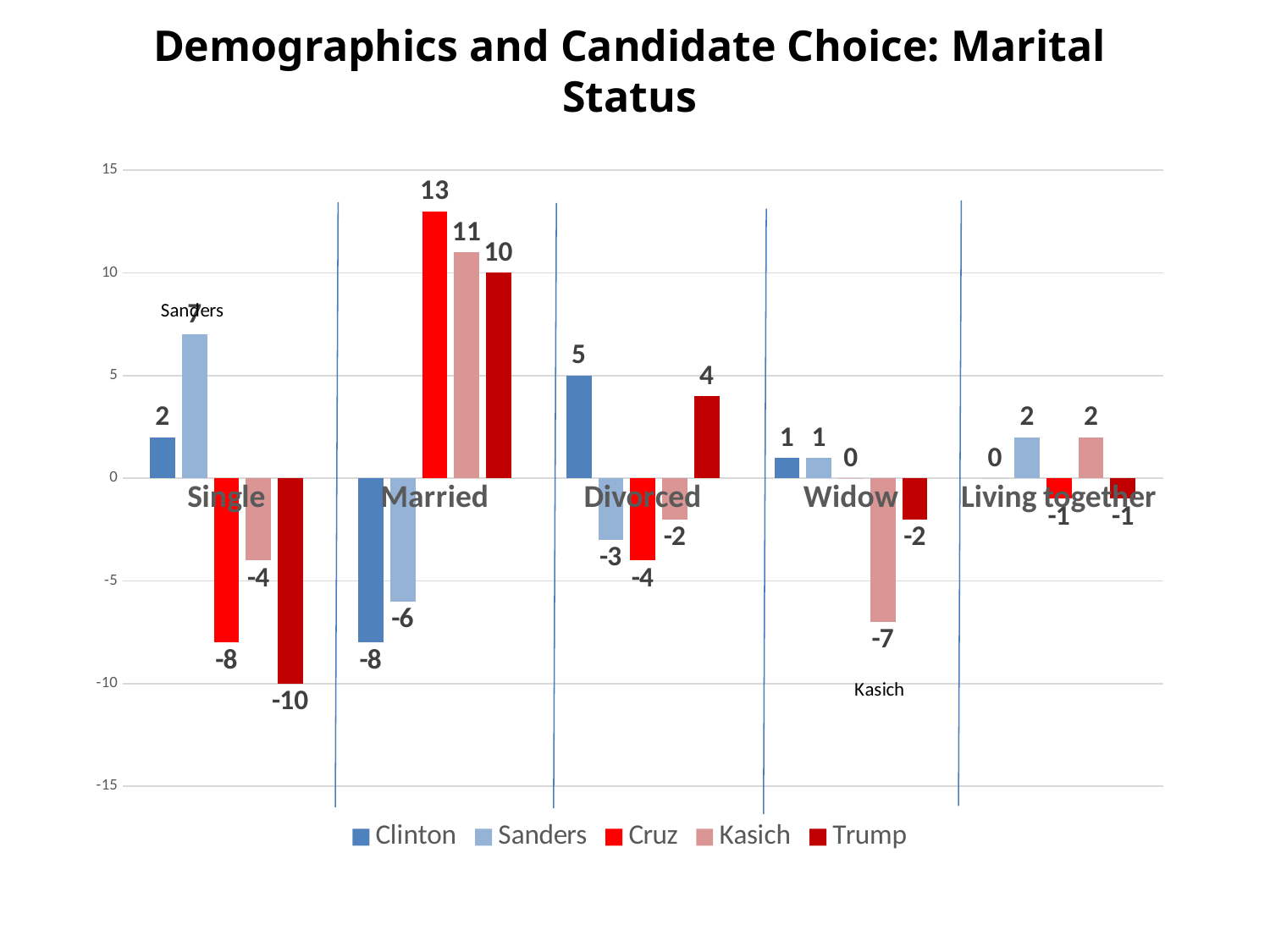
What is the value for Cruz in the Married category? 13 How many series does the legend list? 5 What is the title of the chart? Demographics and Candidate Choice: Marital Status What is the difference between the Cruz and Trump values in the Married category? 3 Which candidate has the lowest value in the Single category? Trump What is the value for Trump in the Single category? -10 What kind of chart is shown on the slide? Bar chart Which candidate has the highest value in the Married category? Cruz What is the value for Clinton in the Divorced category? 5 In the Divorced category, is the value for Clinton or Trump larger? Clinton What is the value for Kasich in the Widow category? -7 How many marital status categories are shown on the x axis? 5